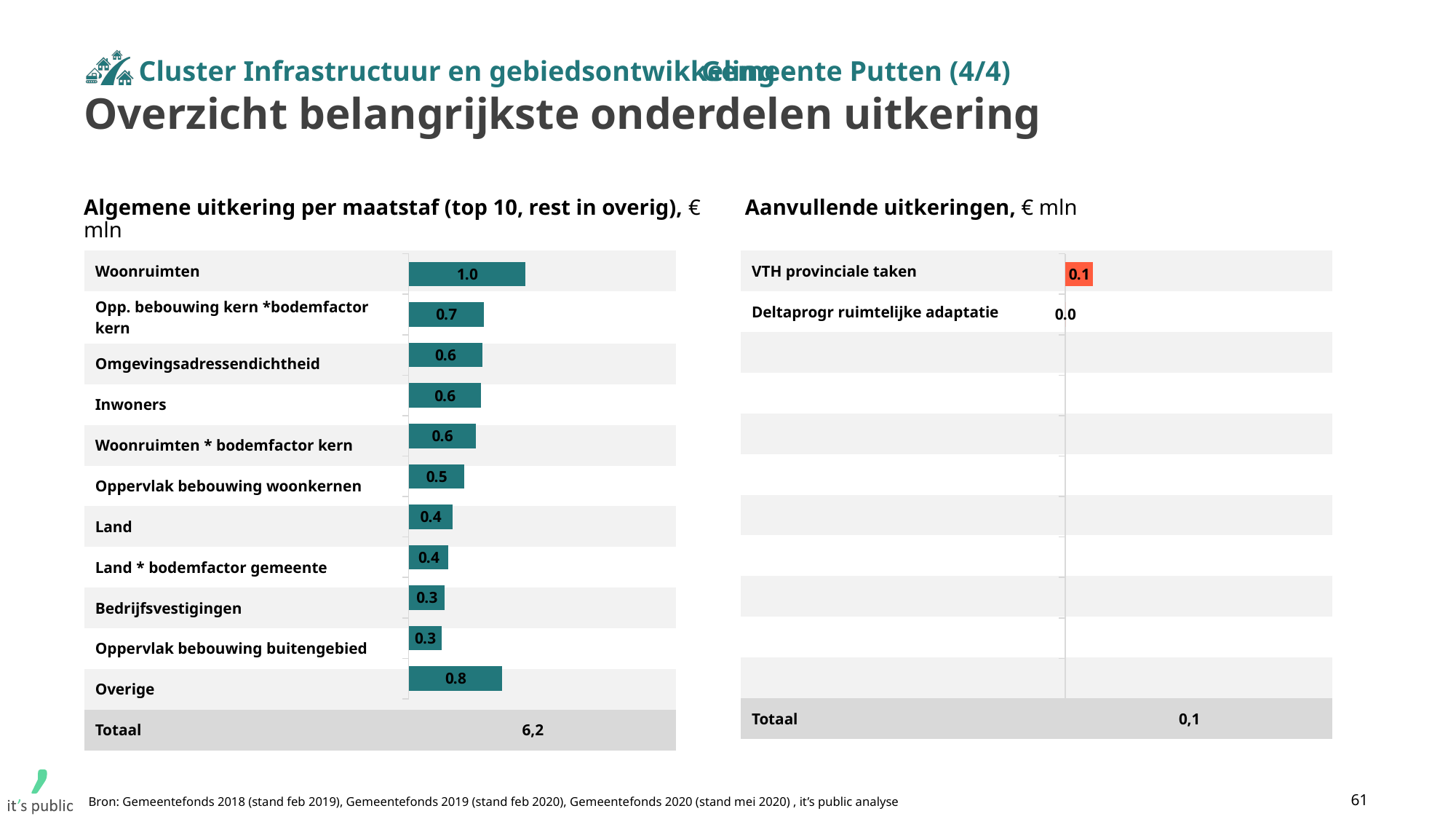
In the chart 'Algemene uitkering per maatstaf', what is the difference between Woonruimten and Opp. bebouwing kern *bodemfactor kern? 0.3 What type of chart is used on the left side of the slide? Bar chart In the chart 'Algemene uitkering per maatstaf', what is the value for Overige? 0.8 In the chart 'Algemene uitkering per maatstaf', what is the value for Woonruimten? 1.0 In the chart 'Algemene uitkering per maatstaf', what is the value for Oppervlak bebouwing woonkernen? 0.5 In the chart 'Algemene uitkering per maatstaf', which is larger: Land or Bedrijfsvestigingen? Land What unit is stated in the title of the chart 'Aanvullende uitkeringen'? € mln How many bars are shown in the chart 'Algemene uitkering per maatstaf'? 11 In the chart 'Algemene uitkering per maatstaf', which category has the highest value? Woonruimten In the chart 'Aanvullende uitkeringen', what is the value for VTH provinciale taken? 0.1 What is the Totaal shown for the chart 'Algemene uitkering per maatstaf'? 6,2 In the chart 'Aanvullende uitkeringen', what is the value for Deltaprogr ruimtelijke adaptatie? 0.0